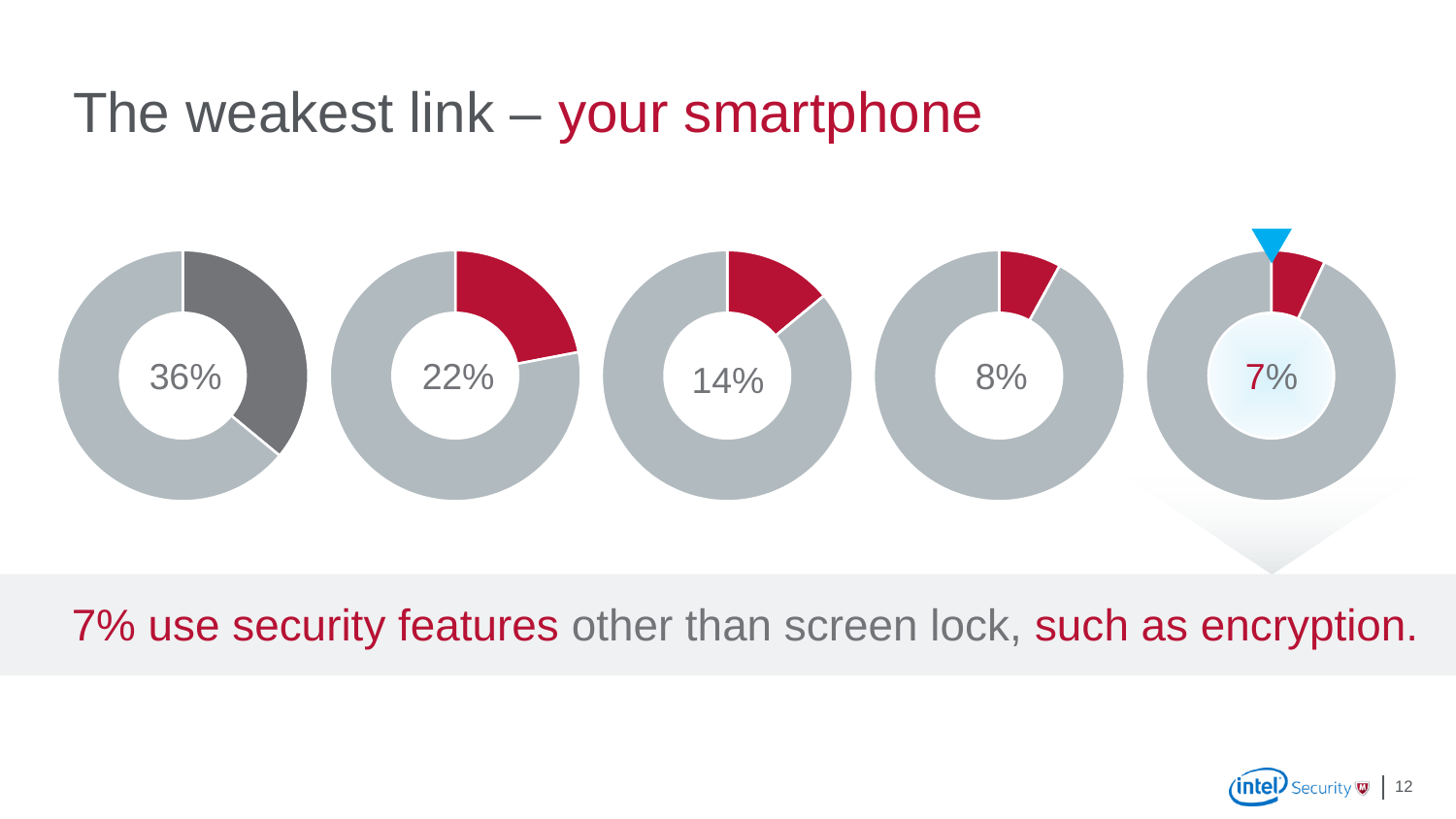
What value is shown in the centre of the fourth donut chart from the left? 8% Which donut chart shows the highest value? The leftmost (36%) What is the difference between the value in the leftmost donut chart and the value in the rightmost donut chart? 29% What kind of charts are shown on the slide? Donut (pie) charts Which is larger, the value in the second donut chart from the left or the value in the middle donut chart? The second from the left (22%) What value is shown in the centre of the second donut chart from the left? 22% Which donut chart shows the lowest value? The rightmost (7%) According to the caption, what does the 7% in the rightmost donut chart represent? Use security features other than screen lock, such as encryption What value is shown in the centre of the leftmost donut chart? 36% What value is shown in the centre of the middle donut chart? 14% What value is shown in the centre of the rightmost donut chart, the one marked with the blue arrow? 7% How many donut charts are shown on the slide? 5